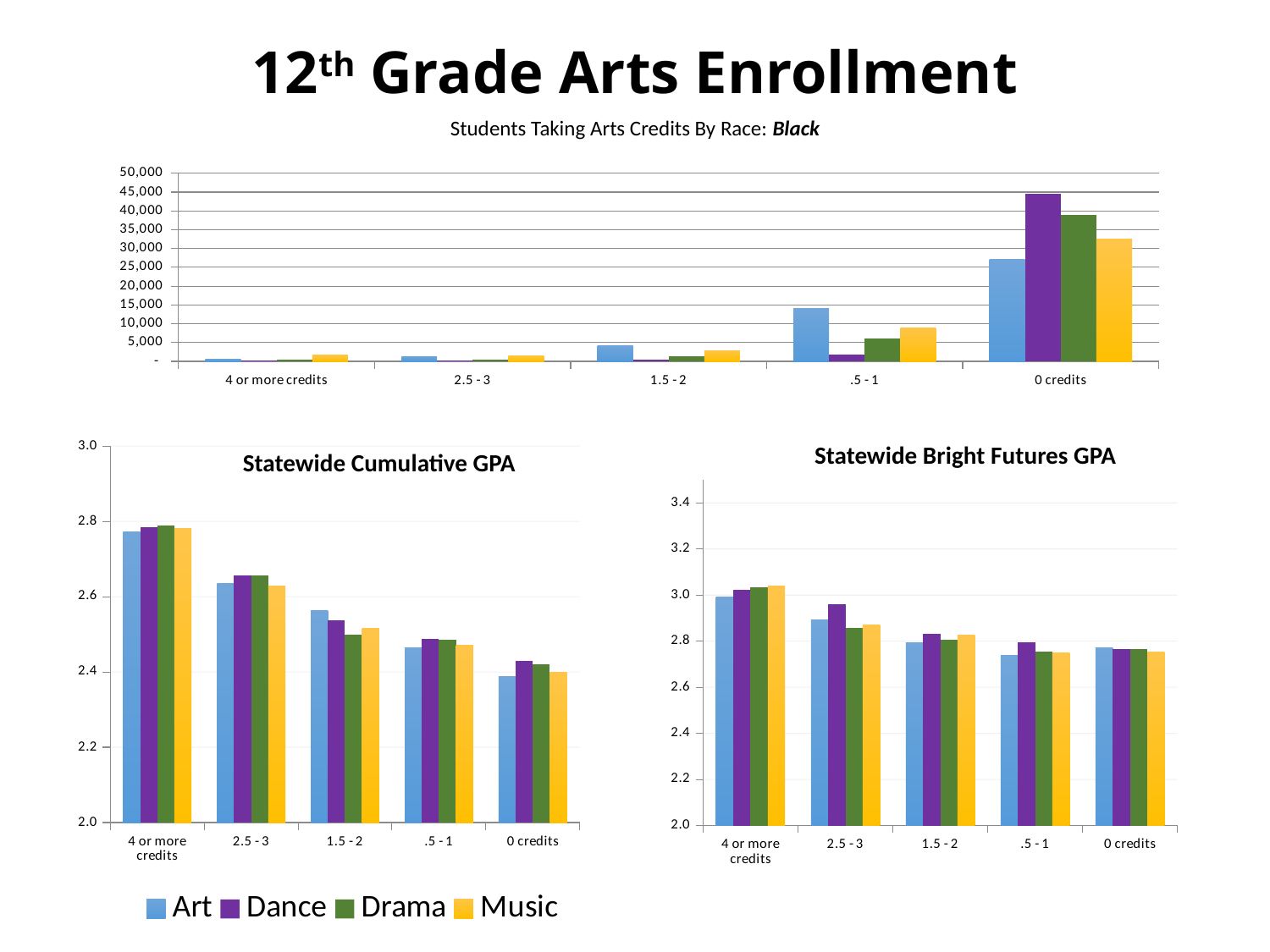
What kind of chart is the 'Statewide Cumulative GPA' chart? bar chart In the 'Statewide Bright Futures GPA' chart, is the Art value for '.5 - 1' credits greater or less than 2.8? less In the 'Statewide Bright Futures GPA' chart, is the Music value for '4 or more credits' greater or less than 3.0? greater In the top chart 'Students Taking Arts Credits By Race: Black', which is larger for 0 credits, Dance or Art? Dance In the top chart 'Students Taking Arts Credits By Race: Black', is the Dance value for .5 - 1 credits greater or less than 5,000? less In the 'Statewide Cumulative GPA' chart, do the values rise or fall moving from '4 or more credits' to '0 credits'? fall Which series is shown in yellow in the legend? Music How many series does the legend list? 4 In the top chart 'Students Taking Arts Credits By Race: Black', which credit category has the highest Dance value? 0 credits In the top chart 'Students Taking Arts Credits By Race: Black', how many credit categories are shown on the x axis? 5